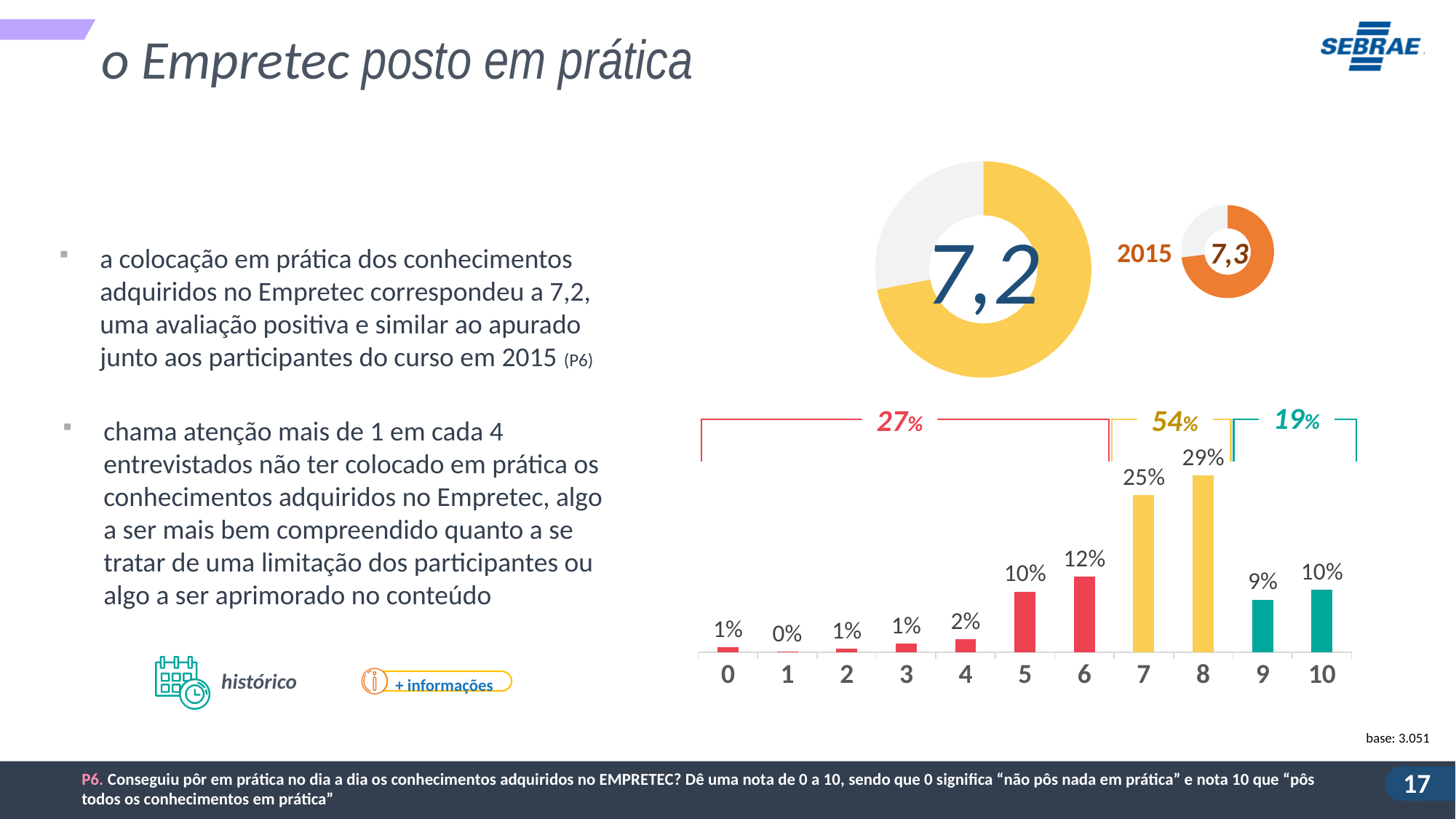
In the bar chart, which score has the highest percentage? 8 In the bar chart, what is the difference between the percentages for score 8 and score 7? 4% In the bar chart, what colour are the bars for scores 9 and 10? green In the bar chart, which score has the lowest percentage? 1 What type of chart shows the distribution of scores from 0 to 10? bar chart What value is shown in the small donut chart labelled 2015? 7,3 In the bar chart, what combined percentage is shown for scores 7 and 8 together? 54% In the bar chart, what percentage is shown for score 5? 10% How many score categories are shown on the x axis of the bar chart? 11 In the bar chart, which has a higher percentage, score 6 or score 10? 6 In the bar chart, what percentage is shown for score 8? 29% What value is shown in the centre of the large donut chart? 7,2